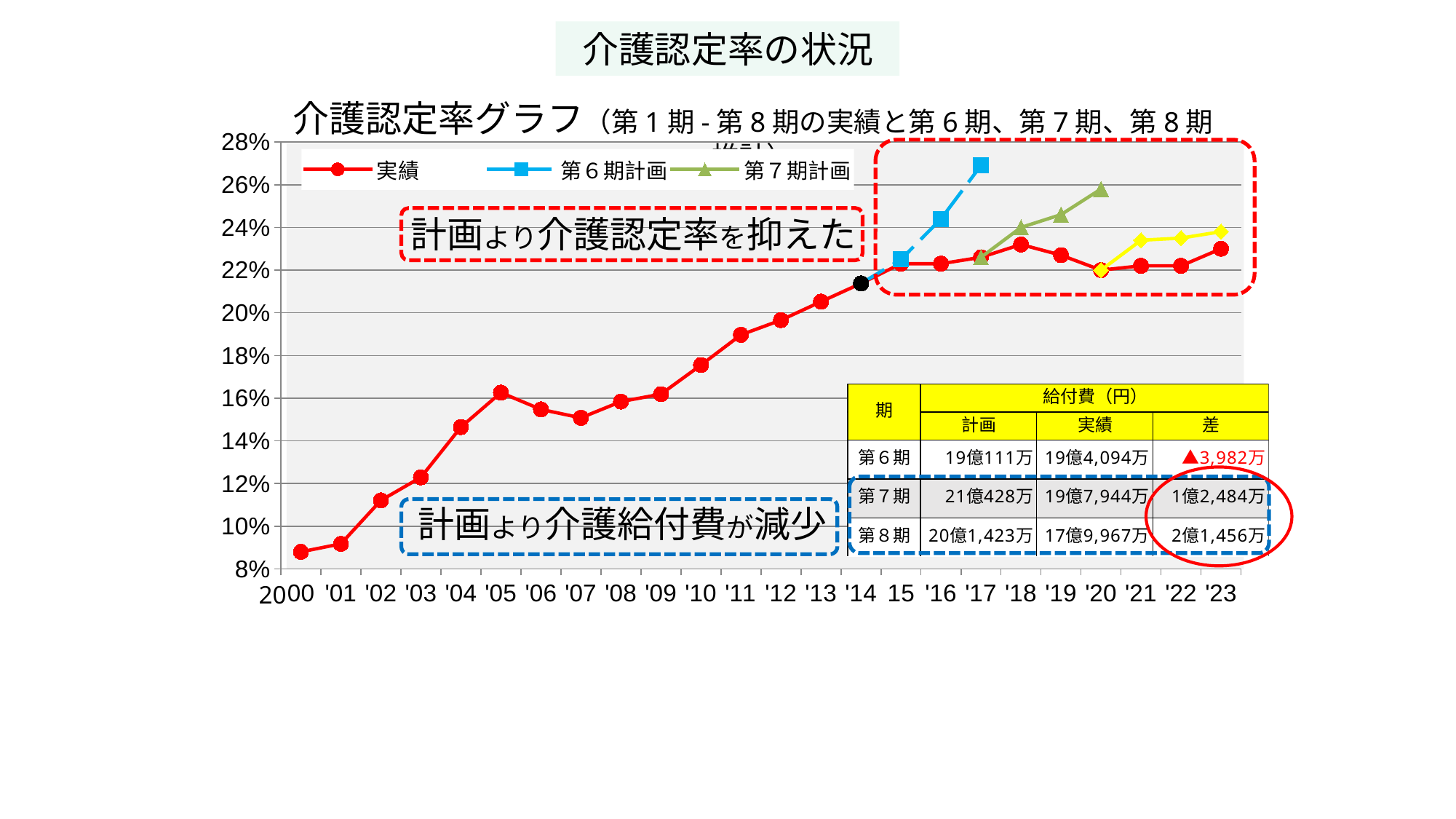
What kind of chart is shown on the slide? line chart Is the 実績 value for '07 greater or less than 16%? less Is the 実績 value for '14 greater or less than 20%? greater Which is larger at '17, the 第6期計画 value or the 実績 value? 第6期計画 In which year is the 実績 series at its lowest? 2000 Does the 実績 series rise or fall from 2000 to '14? rise Is the 第6期計画 value for '17 greater or less than 26%? greater What colour is the 実績 series line? red How many series does the chart legend list? 3